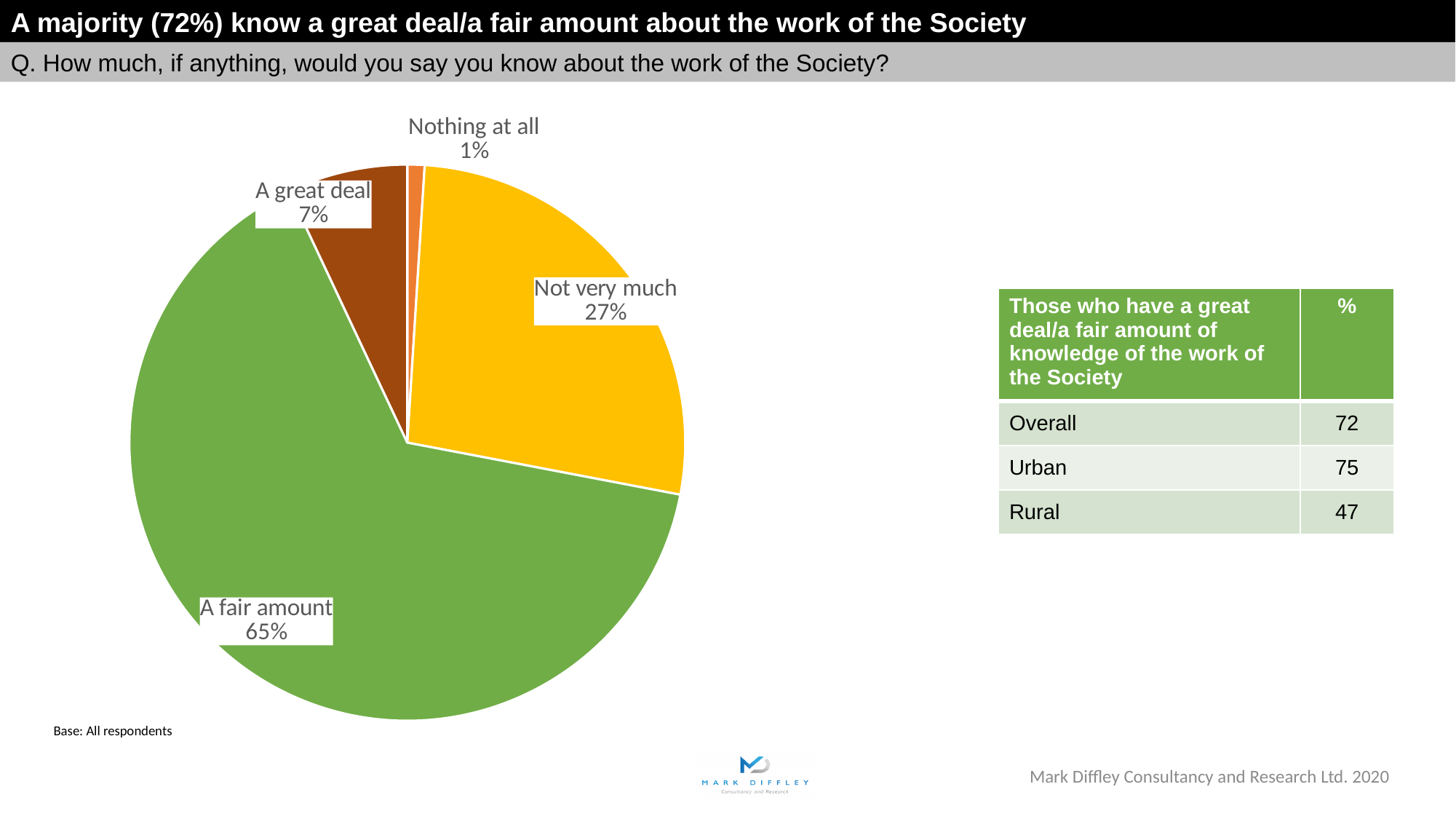
What percentage of respondents say they know 'A fair amount' about the work of the Society? 65% What type of chart is shown on the slide? Pie chart What percentage of respondents say they know 'Not very much' about the work of the Society? 27% Which response category has the smallest share of the pie? Nothing at all What is the combined share of 'A great deal' and 'A fair amount'? 72% What is the difference in percentage points between 'A fair amount' and 'Not very much'? 38 Which response category has the largest share of the pie? A fair amount What colour is the 'Not very much' slice of the pie chart? Yellow What percentage of respondents say they know 'Nothing at all' about the work of the Society? 1% What percentage of respondents say they know 'A great deal' about the work of the Society? 7% How many slices does the pie chart have? 4 Which is larger: the share for 'A great deal' or the share for 'Not very much'? Not very much